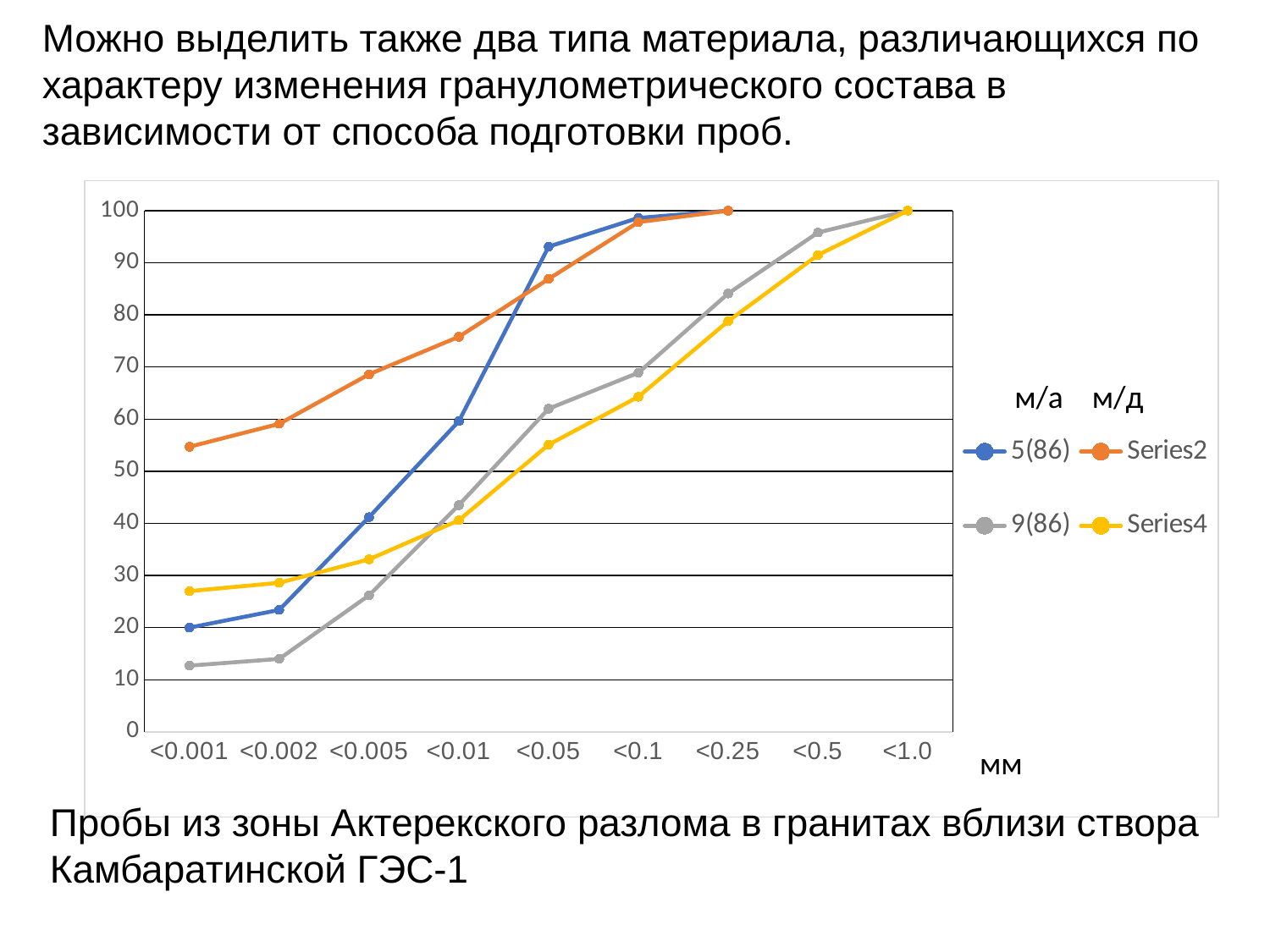
Do the values of series 9(86) rise or fall along the x axis? rise Is the value of series 9(86) at <0.001 greater or less than 20? less How many series does the legend list? 4 What is the value of Series2 at <0.25? 100 What kind of chart is shown on the slide? line chart Is the value of series 5(86) at <0.05 greater or less than 90? greater Which series has the lowest value at <0.001? 9(86) How many categories are shown on the x axis? 9 Is the value of Series2 at <0.001 greater or less than 50? greater At <0.05, which is larger: series 5(86) or Series2? 5(86) Which series has the highest value at <0.001? Series2